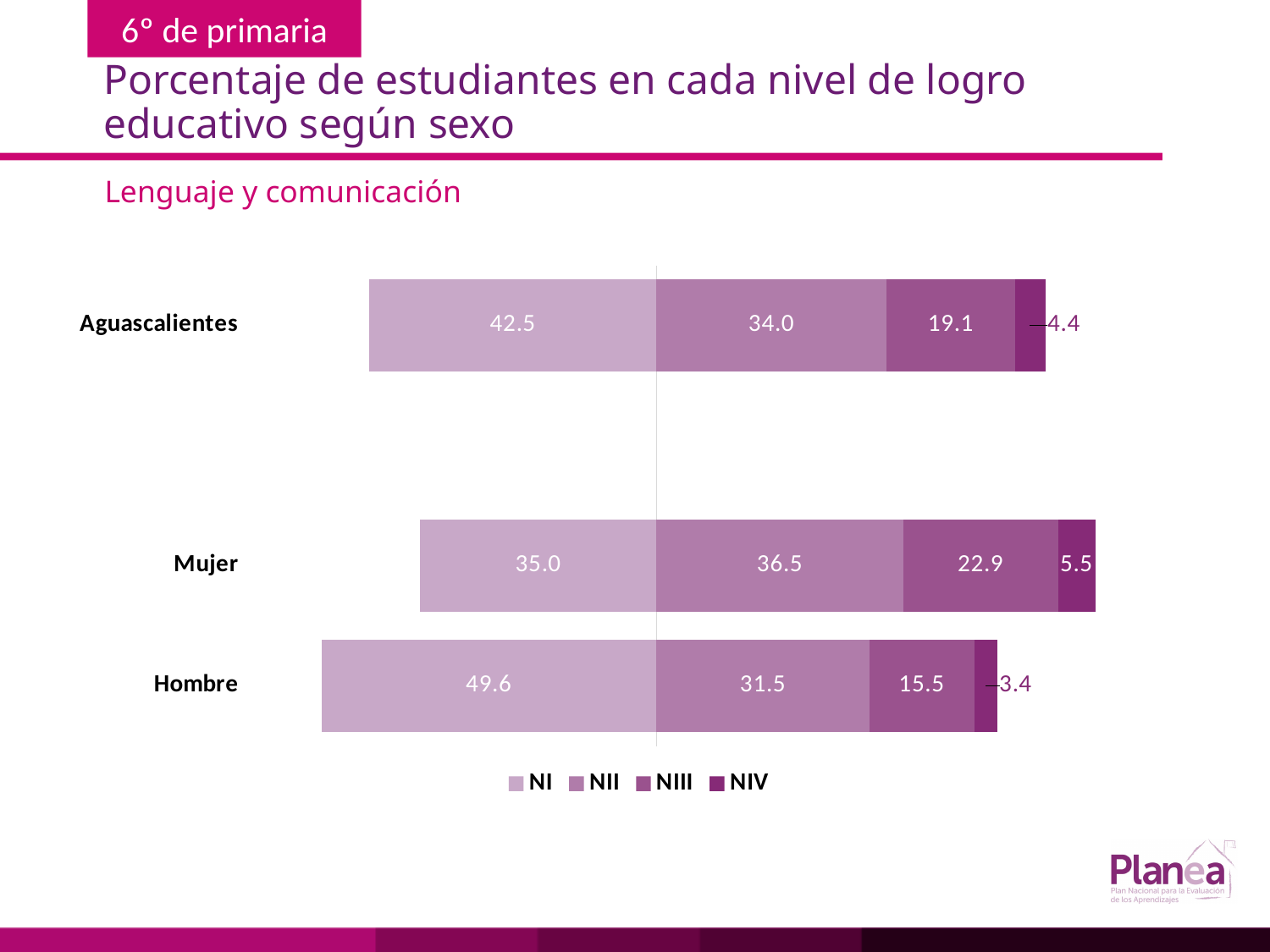
What is the total of the stacked bar for Hombre? 100.0 Which category has the lowest NIV value? Hombre What is the difference between the NI values for Hombre and Mujer? 14.6 What is the NIII value for Aguascalientes? 19.1 How many categories are shown on the chart? 3 What is the NI value for Hombre? 49.6 Which category has the highest NI value? Hombre Which is larger, the NIII value for Mujer or the NIII value for Aguascalientes? Mujer What kind of chart is shown on the slide? Stacked bar chart How many series does the legend list? 4 What is the NIV value for Mujer? 5.5 What is the NII value for Mujer? 36.5